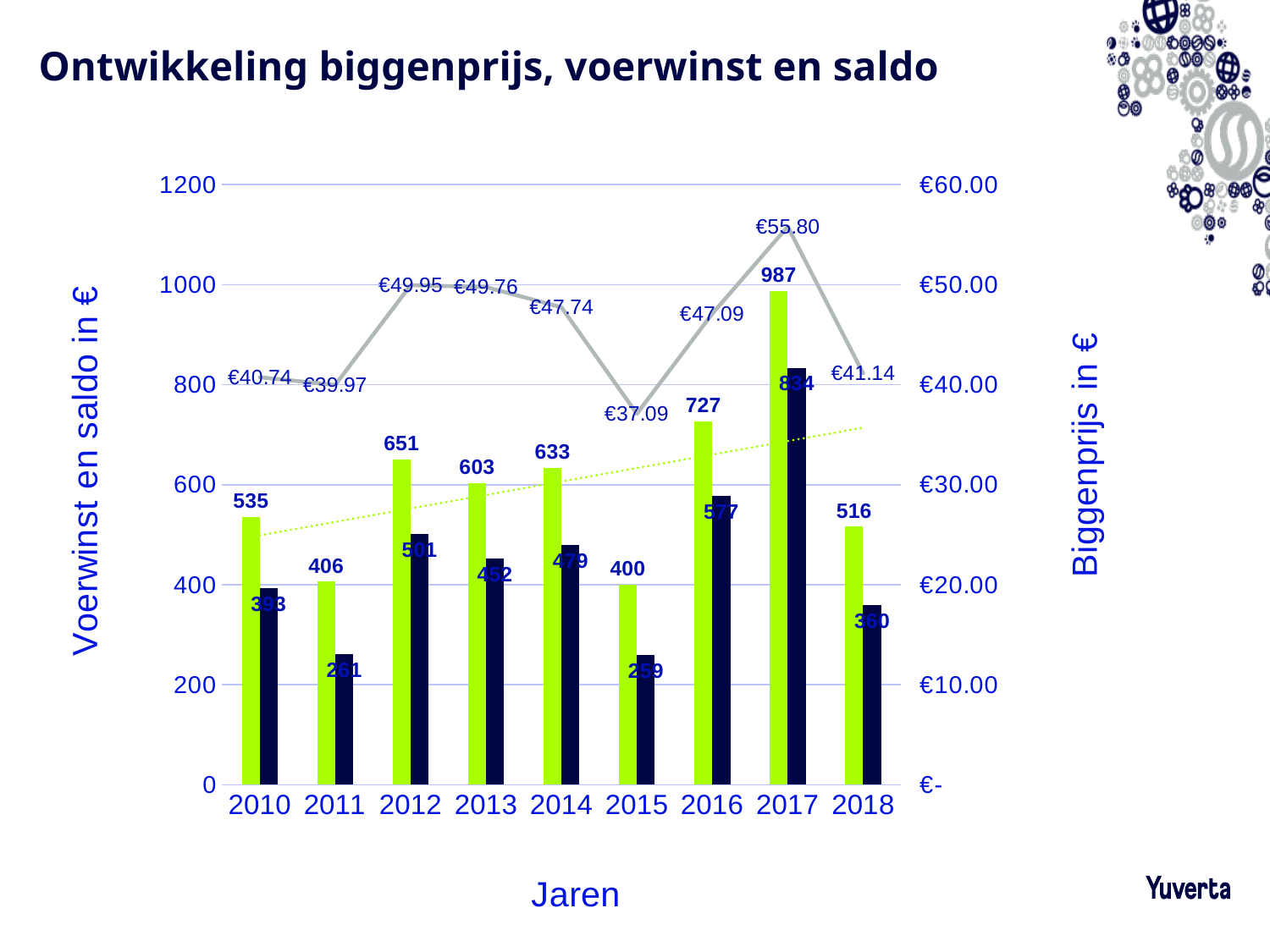
In which year is the green bar the lowest? 2015 Which is larger: the green bar for 2012 or the green bar for 2014? 2012 What is the title of the chart? Ontwikkeling biggenprijs, voerwinst en saldo How many years are shown on the x axis? 9 What value does the grey line show for 2015? €37.09 What is the difference between the grey line values for 2017 and 2018? €14.66 Is the dark blue bar for 2017 greater or less than 800? greater What is the value of the dark blue bar for 2011? 261 What is the difference between the green bar and the dark blue bar for 2016? 150 In which year does the grey line reach its highest value? 2017 What is the value of the green bar for 2017? 987 What is the label of the right-hand vertical axis? Biggenprijs in €